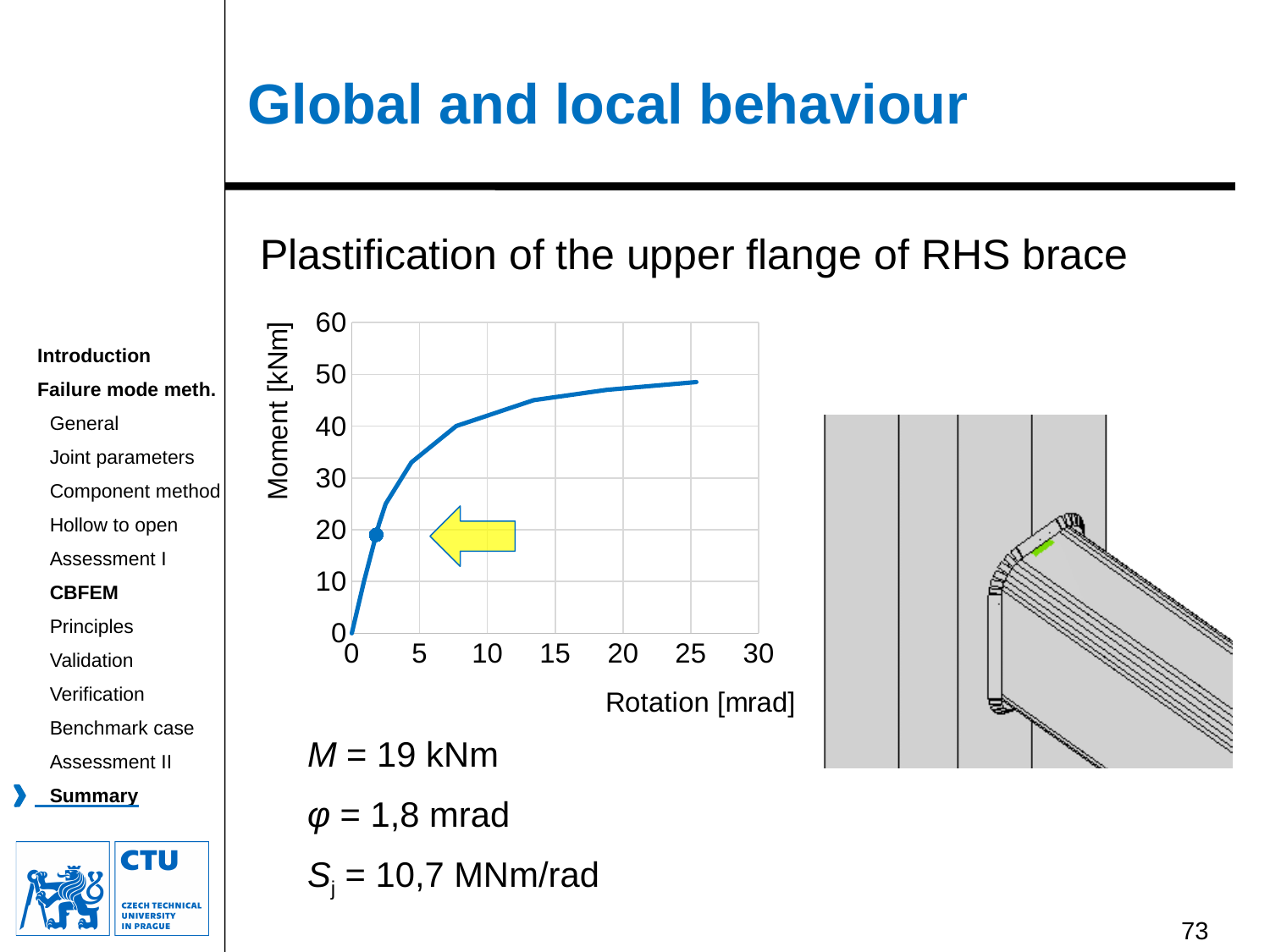
What kind of chart is shown on the slide? line chart Is the moment at a rotation of 5 mrad greater or less than 20 kNm? greater How many curves are plotted on the chart? 1 What is the rotation φ at the marked point on the curve? 1,8 mrad What is the label of the vertical axis of the chart? Moment [kNm] Does the moment rise or fall as the rotation increases along the x axis? rise What is the label of the horizontal axis of the chart? Rotation [mrad] Is the moment at a rotation of 25 mrad greater or less than 40 kNm? greater What is the moment value M at the marked point on the curve? 19 kNm What is the highest value shown on the vertical axis of the chart? 60 Is the moment at a rotation of 1 mrad greater or less than 20 kNm? less